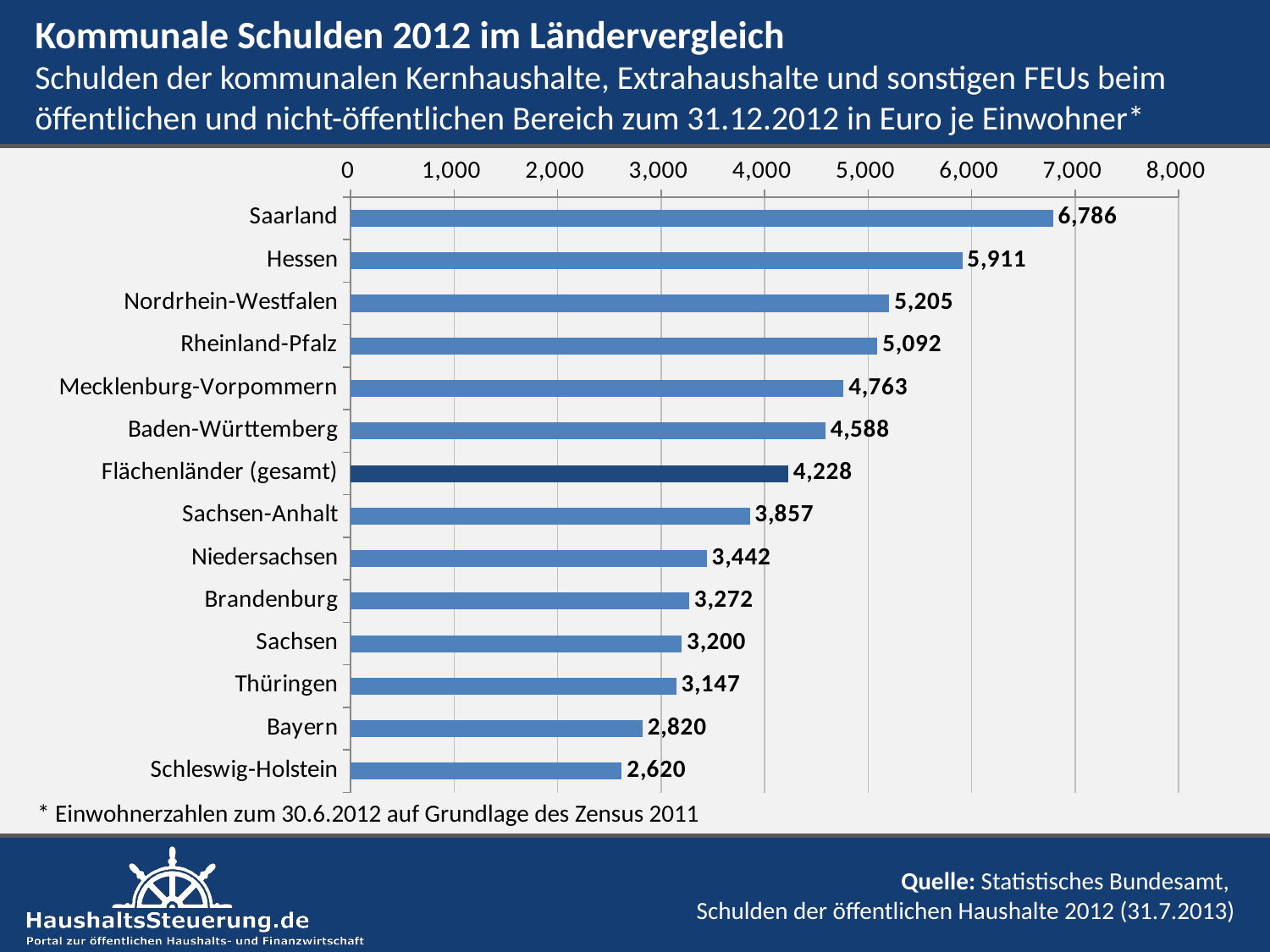
What is the value for Bayern? 2,820 What is the difference between the values for Saarland and Hessen? 875 Which is larger, the value for Brandenburg or the value for Sachsen? Brandenburg What is the value for Saarland? 6,786 Which bar is shown in a darker blue than the others? Flächenländer (gesamt) Is the value for Mecklenburg-Vorpommern greater or less than 4,000? greater Which category has the highest value? Saarland What is the difference between the values for Thüringen and Schleswig-Holstein? 527 Which category has the lowest value? Schleswig-Holstein What is the value for Flächenländer (gesamt)? 4,228 How many categories are shown in the chart? 14 What kind of chart is shown on the slide? bar chart